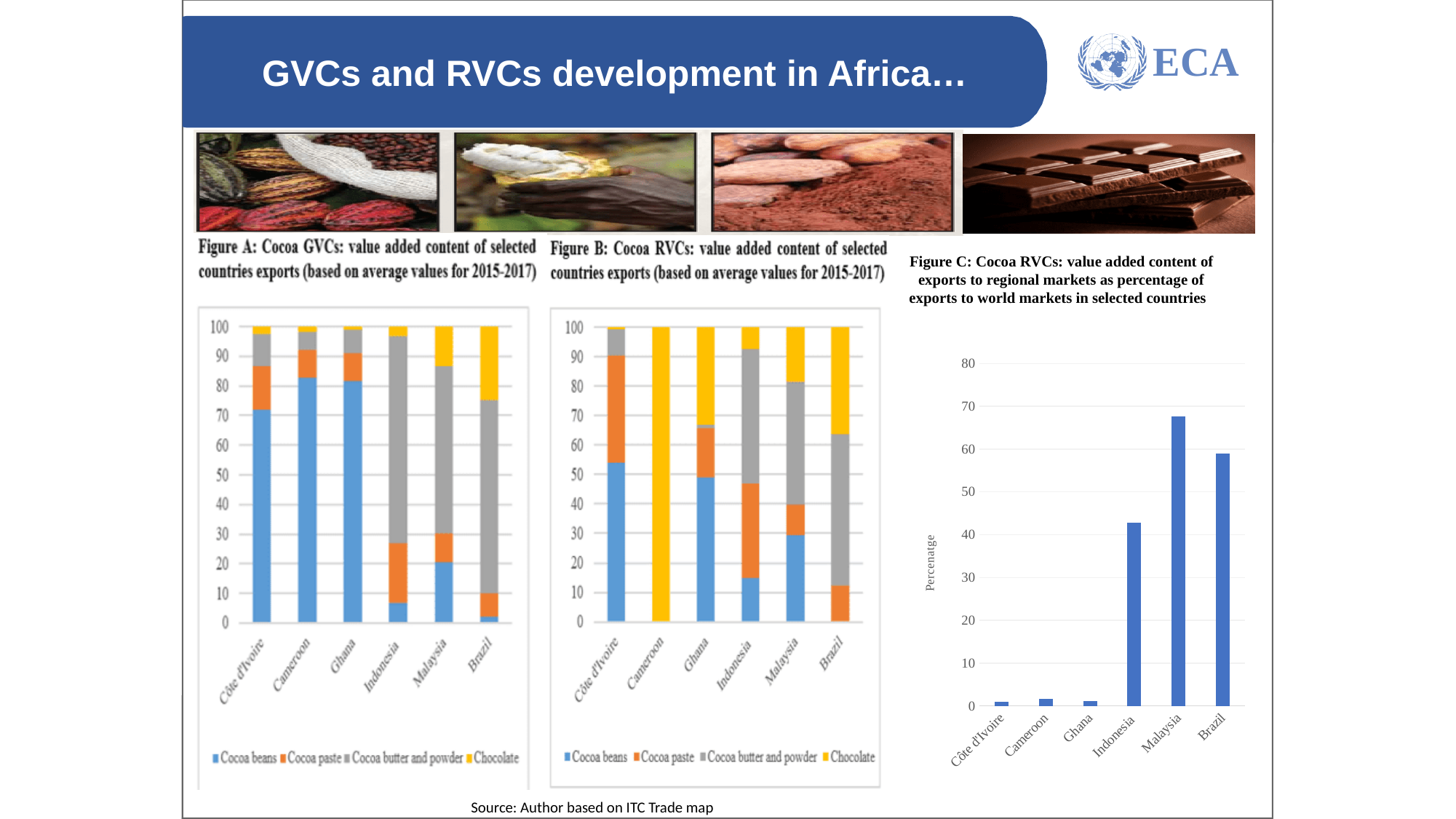
In Figure C, is the value for Brazil greater or less than 50? greater What kind of chart is Figure C? bar chart In Figure A, is the Cocoa beans value for Côte d'Ivoire greater or less than 60? greater How many series does the legend of Figure A list? 4 In Figure A, which country has the lowest Cocoa beans share? Brazil In Figure C, is the value for Indonesia greater or less than 50? less In Figure C, which is larger, the value for Brazil or the value for Indonesia? Brazil In Figure C, which country has the highest value? Malaysia In Figure B, which series makes up the entire bar for Cameroon? Chocolate How many countries are shown on the x axis of Figure C? 6